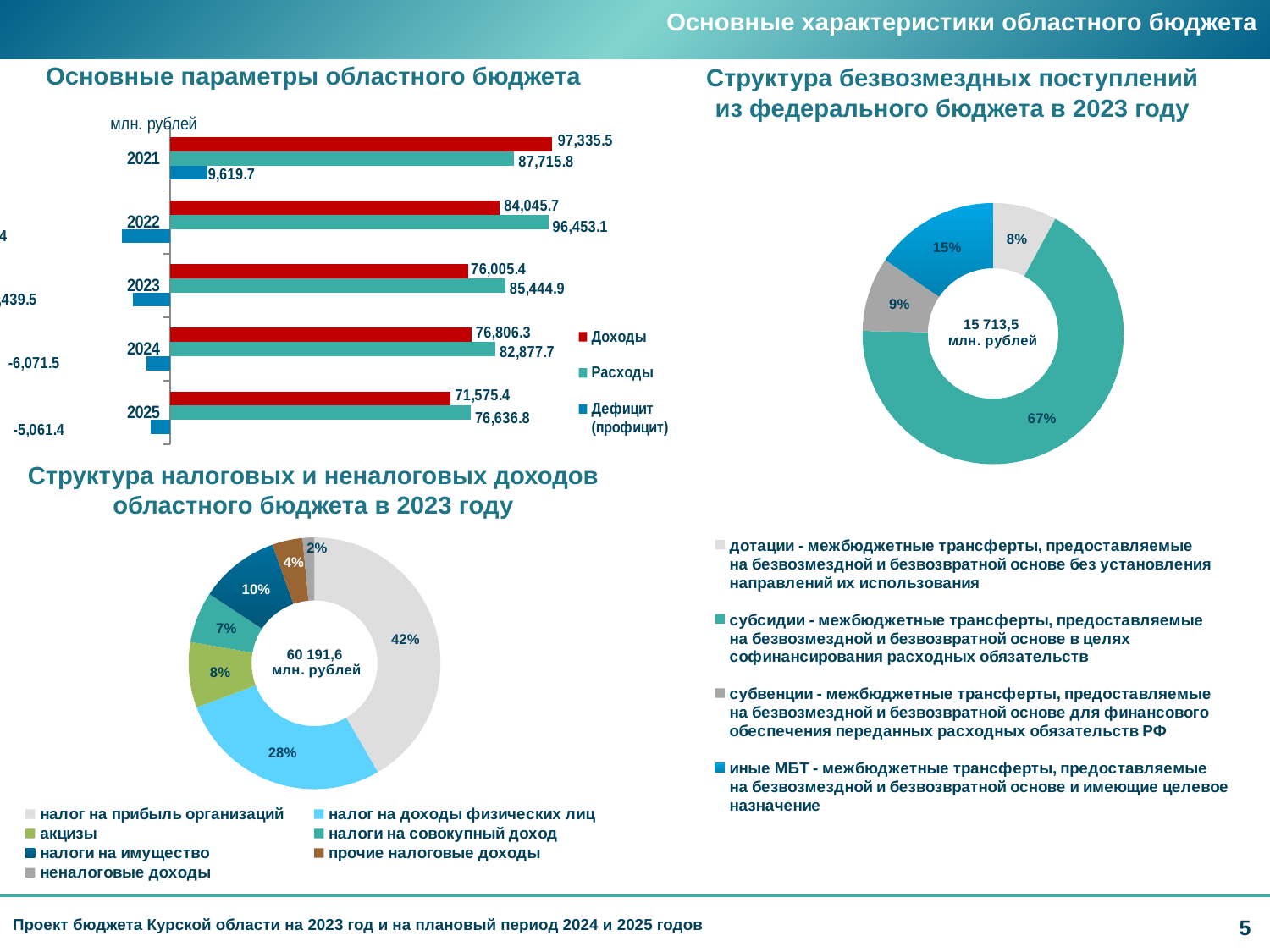
In the chart 'Основные параметры областного бюджета', what is the value of Дефицит (профицит) for 2025? -5,061.4 How many series does the legend of the chart 'Основные параметры областного бюджета' list? 3 In the chart 'Основные параметры областного бюджета', which is larger for 2024: Доходы or Расходы? Расходы In the chart 'Структура безвозмездных поступлений из федерального бюджета в 2023 году', what share is субсидии? 67% In the chart 'Основные параметры областного бюджета', which year has the highest Доходы value? 2021 What type of chart is 'Основные параметры областного бюджета'? Bar chart What total value is shown in the centre of the chart 'Структура безвозмездных поступлений из федерального бюджета в 2023 году'? 15 713,5 млн. рублей In the chart 'Структура налоговых и неналоговых доходов областного бюджета в 2023 году', what share is налог на доходы физических лиц? 28% In the chart 'Основные параметры областного бюджета', what is the difference between Расходы and Доходы for 2023? 9,439.5 In the chart 'Основные параметры областного бюджета', what is the value of Доходы for 2021? 97,335.5 In the chart 'Структура налоговых и неналоговых доходов областного бюджета в 2023 году', which category has the largest share? налог на прибыль организаций In the chart 'Основные параметры областного бюджета', what is the value of Расходы for 2022? 96,453.1